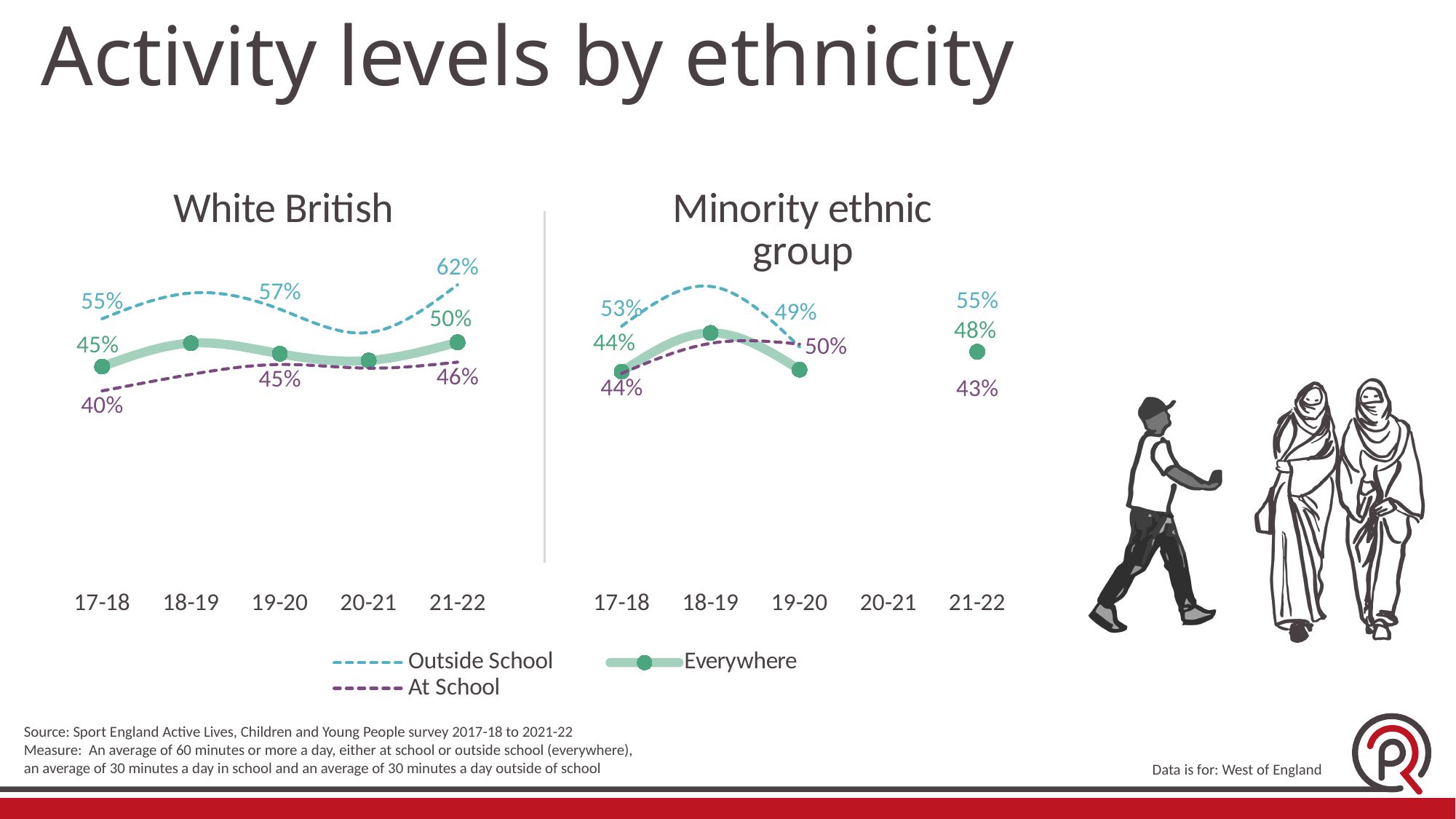
In the Minority ethnic group chart, what is the Everywhere value for 21-22? 48% What kind of chart is the White British chart? Line chart In the White British chart, by how many percentage points did the Outside School value change from 17-18 to 21-22? 7 percentage points In the White British chart, what is the Outside School value for 21-22? 62% Which is larger for 21-22 Outside School: the White British chart or the Minority ethnic group chart? White British In the White British chart, what is the At School value for 17-18? 40% In the Minority ethnic group chart, what is the Outside School value for 17-18? 53% In the White British chart, which period has the highest Outside School value? 21-22 In the Minority ethnic group chart, what is the At School value for 21-22? 43% How many time periods are shown on the x axis of the White British chart? 5 In the White British chart, does the At School series rise or fall from 17-18 to 21-22? Rise How many series does the legend list? 3